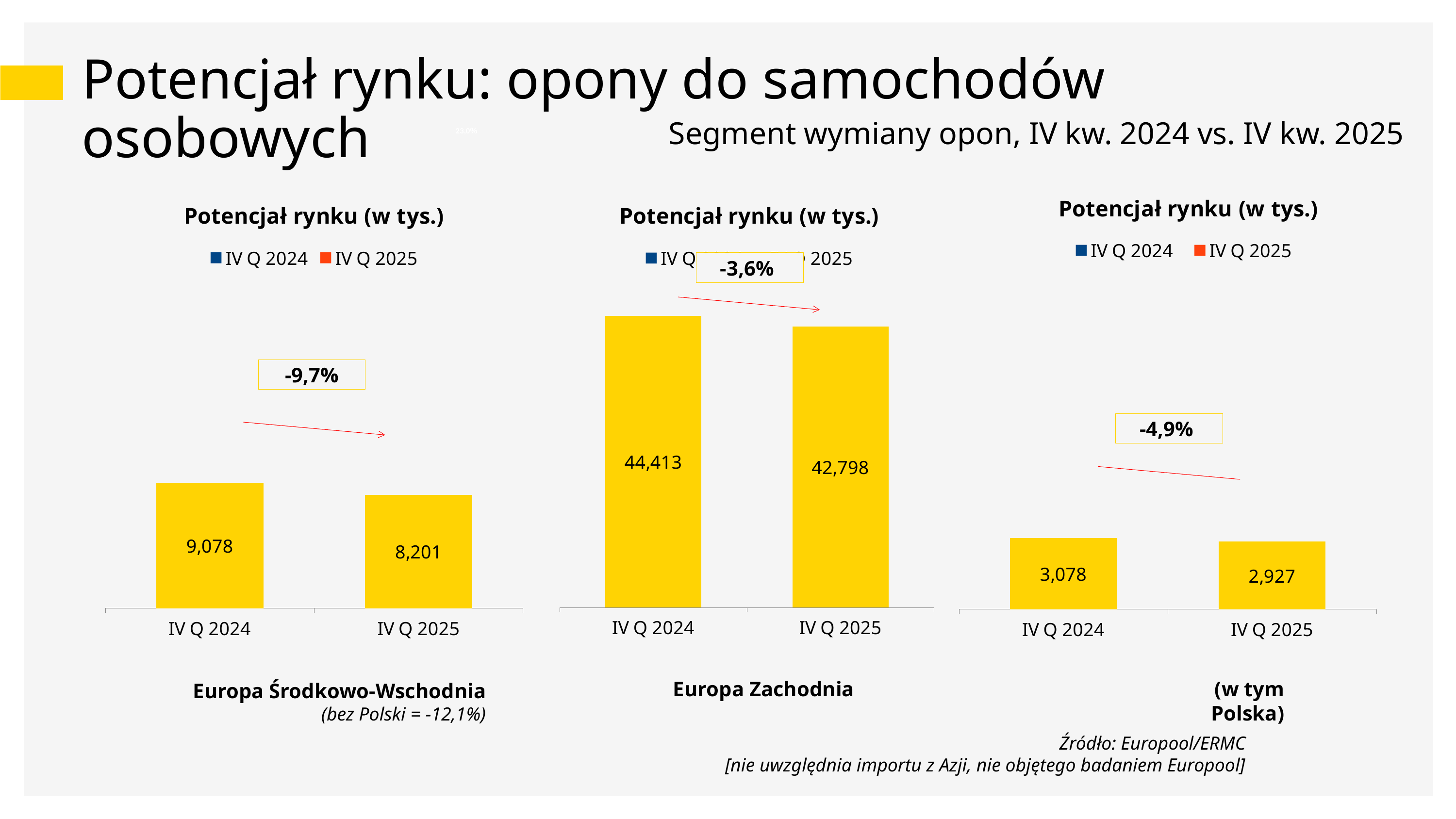
In the left chart (Europa Środkowo-Wschodnia), what is the value for IV Q 2024? 9,078 What kind of chart is the right chart (w tym Polska)? bar chart What percentage change is shown in the box above the bars in the left chart (Europa Środkowo-Wschodnia)? -9,7% How many series does the legend of the left chart (Europa Środkowo-Wschodnia) list? 2 In the middle chart (Europa Zachodnia), what is the value for IV Q 2025? 42,798 In the middle chart (Europa Zachodnia), by how much did the value fall from IV Q 2024 to IV Q 2025? 1,615 In the middle chart (Europa Zachodnia), do the values rise or fall from IV Q 2024 to IV Q 2025? fall In the right chart (w tym Polska), what is the value for IV Q 2025? 2,927 In the right chart (w tym Polska), what is the difference between the IV Q 2024 and IV Q 2025 values? 151 In the left chart (Europa Środkowo-Wschodnia), which bar is higher, IV Q 2024 or IV Q 2025? IV Q 2024 In the left chart (Europa Środkowo-Wschodnia), what is the value for IV Q 2025? 8,201 In the middle chart (Europa Zachodnia), what is the value for IV Q 2024? 44,413